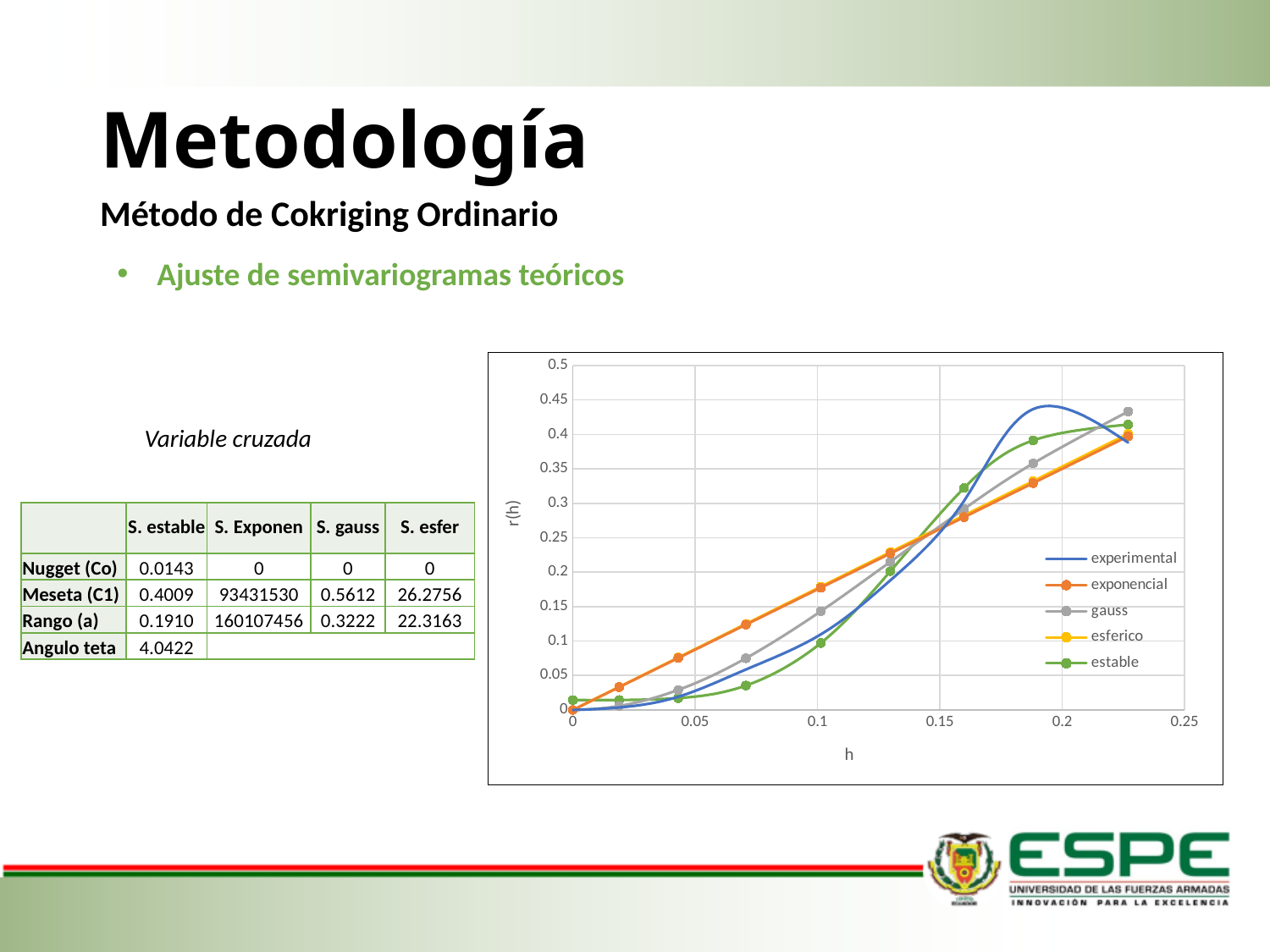
Is the value of the exponencial series at h = 0.1 greater or less than 0.2? less How many series does the chart legend list? 5 Does the exponencial series rise or fall as h increases? rise Is the value of the exponencial series at h = 0.19 greater or less than 0.3? greater At the largest h value plotted, which series has the highest point? gauss At h = 0.1, which series has the larger value, exponencial or estable? exponencial Is the value of the estable series at h = 0.07 greater or less than 0.05? less What is the label of the vertical axis of the chart? r(h) What is the label of the horizontal axis of the chart? h What kind of chart is shown on the slide? line chart